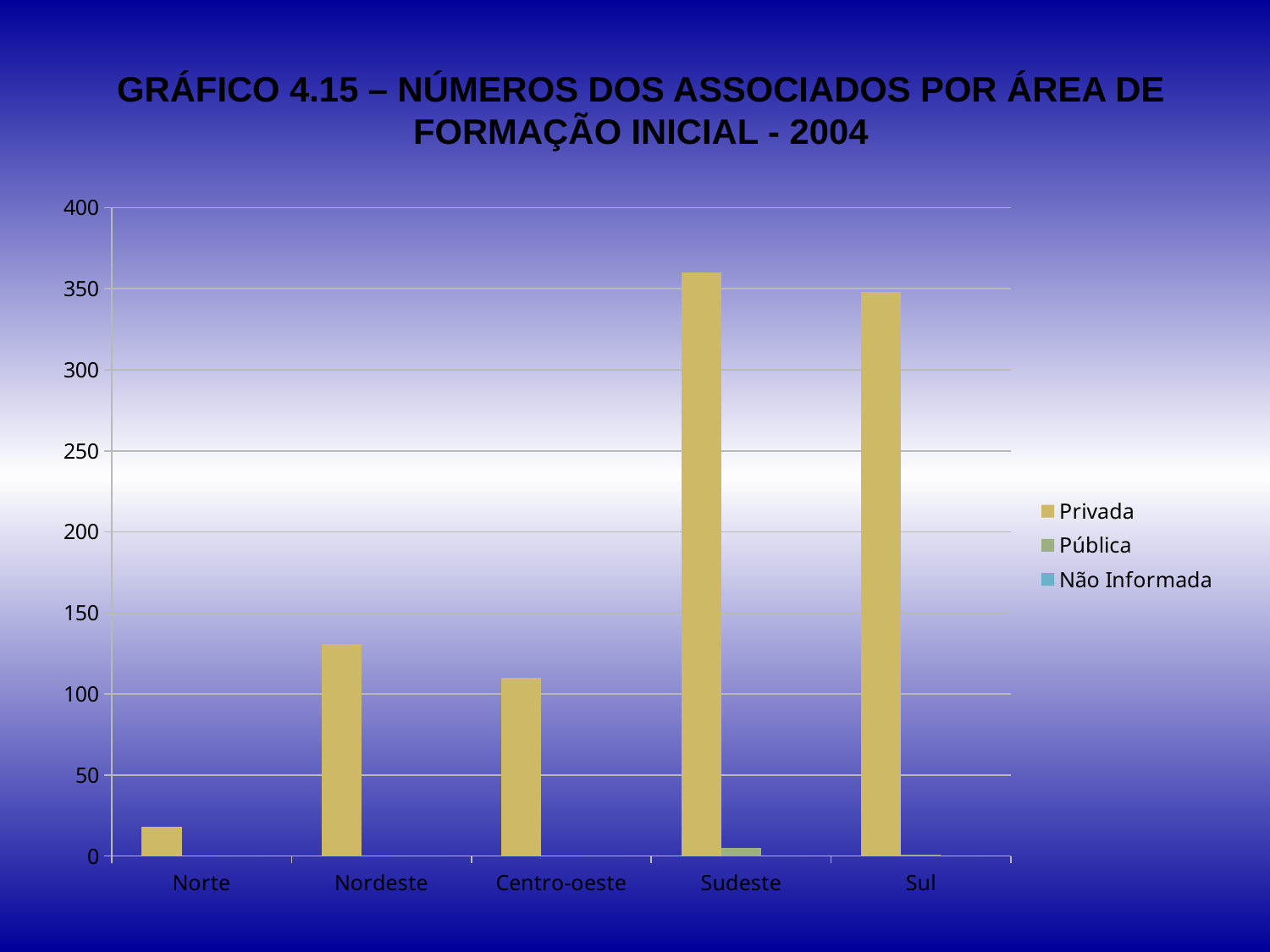
Which region has the lowest value for Privada? Norte What kind of chart is shown on the slide? bar chart What is the title of the chart? GRÁFICO 4.15 – NÚMEROS DOS ASSOCIADOS POR ÁREA DE FORMAÇÃO INICIAL - 2004 Which region has the highest value for Privada? Sudeste Is the Privada value for Sudeste greater or less than 350? greater Which is larger, the Privada value for Sudeste or for Sul? Sudeste Which is larger, the Privada value for Nordeste or for Centro-oeste? Nordeste How many regions are shown on the x axis of the chart? 5 Is the Privada value for Norte greater or less than 50? less Is the Privada value for Nordeste greater or less than 100? greater How many series does the legend list? 3